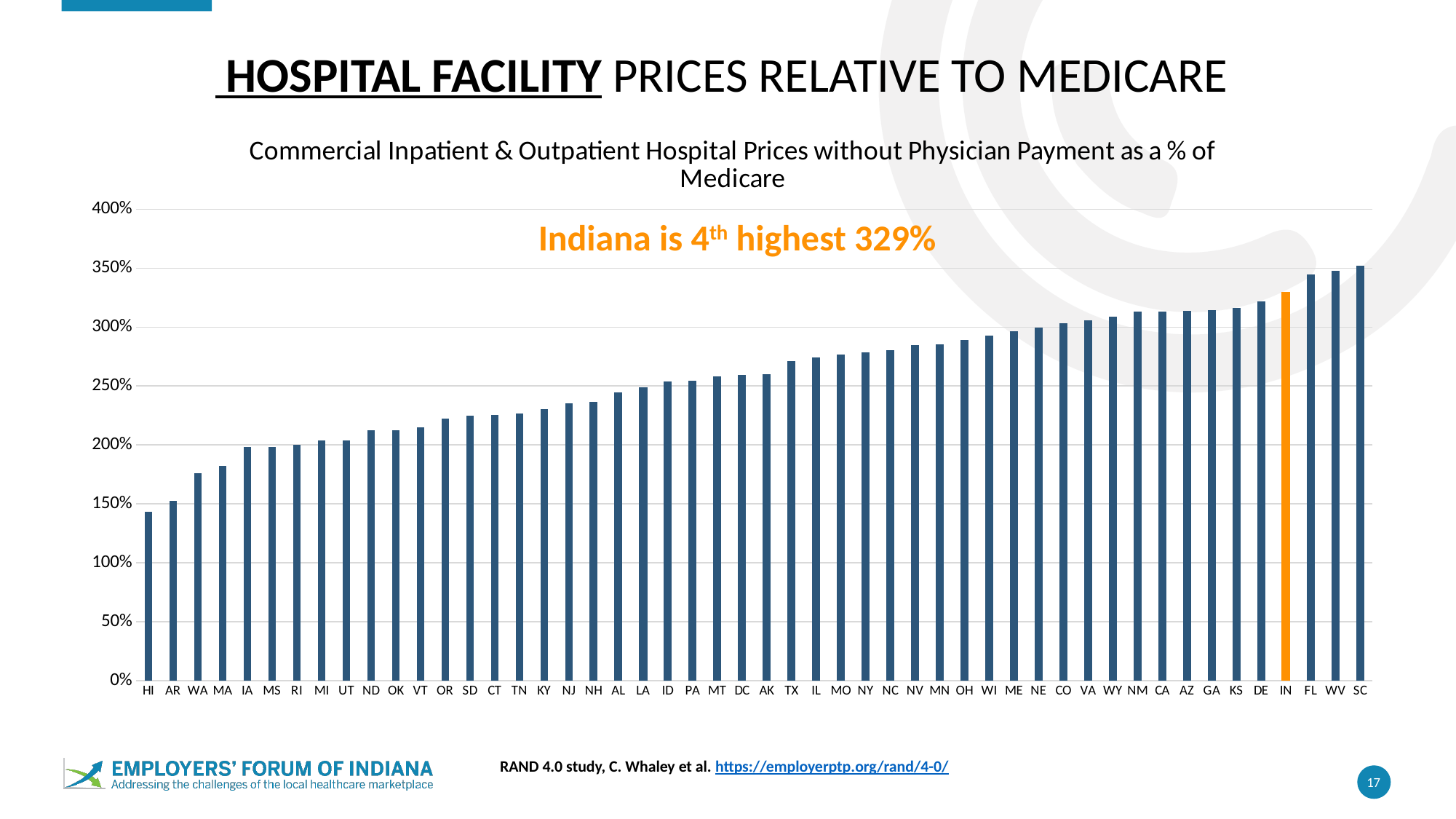
Is the value for WA greater or less than 200%? less How many states/categories are plotted on the chart? 50 Is the value for TX greater or less than 250%? greater What kind of chart is shown on the slide? bar chart Which has a higher value, AR or NJ? NJ Which state has the lowest hospital facility price relative to Medicare? HI Do the values rise or fall moving from left to right along the x axis? rise What is Indiana's (IN) hospital facility price as a % of Medicare? 329% Which state has the highest hospital facility price relative to Medicare? SC Which state's bar is highlighted in orange? IN Is the value for HI greater or less than 150%? less